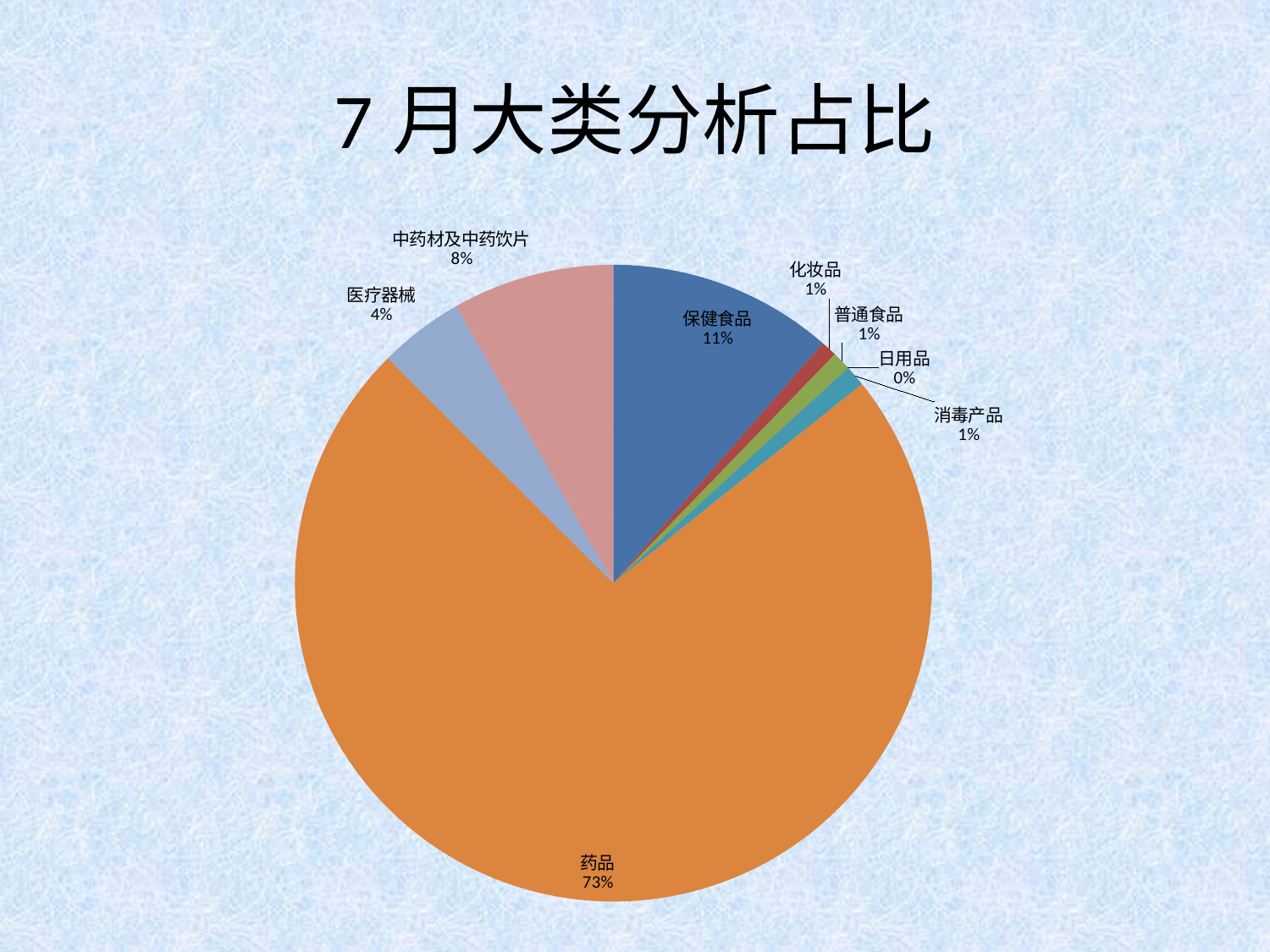
What is the value shown for 日用品? 0% What is the value shown for 中药材及中药饮片? 8% What share of the pie does 药品 account for? 73% How many categories are shown in the pie chart? 8 Which is larger, the share of 中药材及中药饮片 or the share of 医疗器械? 中药材及中药饮片 What is the title of the chart? 7月大类分析占比 What is the difference between the shares of 药品 and 保健食品? 62% What is the value shown for 保健食品? 11% Which category has the smallest slice of the pie? 日用品 What kind of chart is shown on the slide? Pie chart What is the value shown for 医疗器械? 4% Which category has the largest slice of the pie? 药品